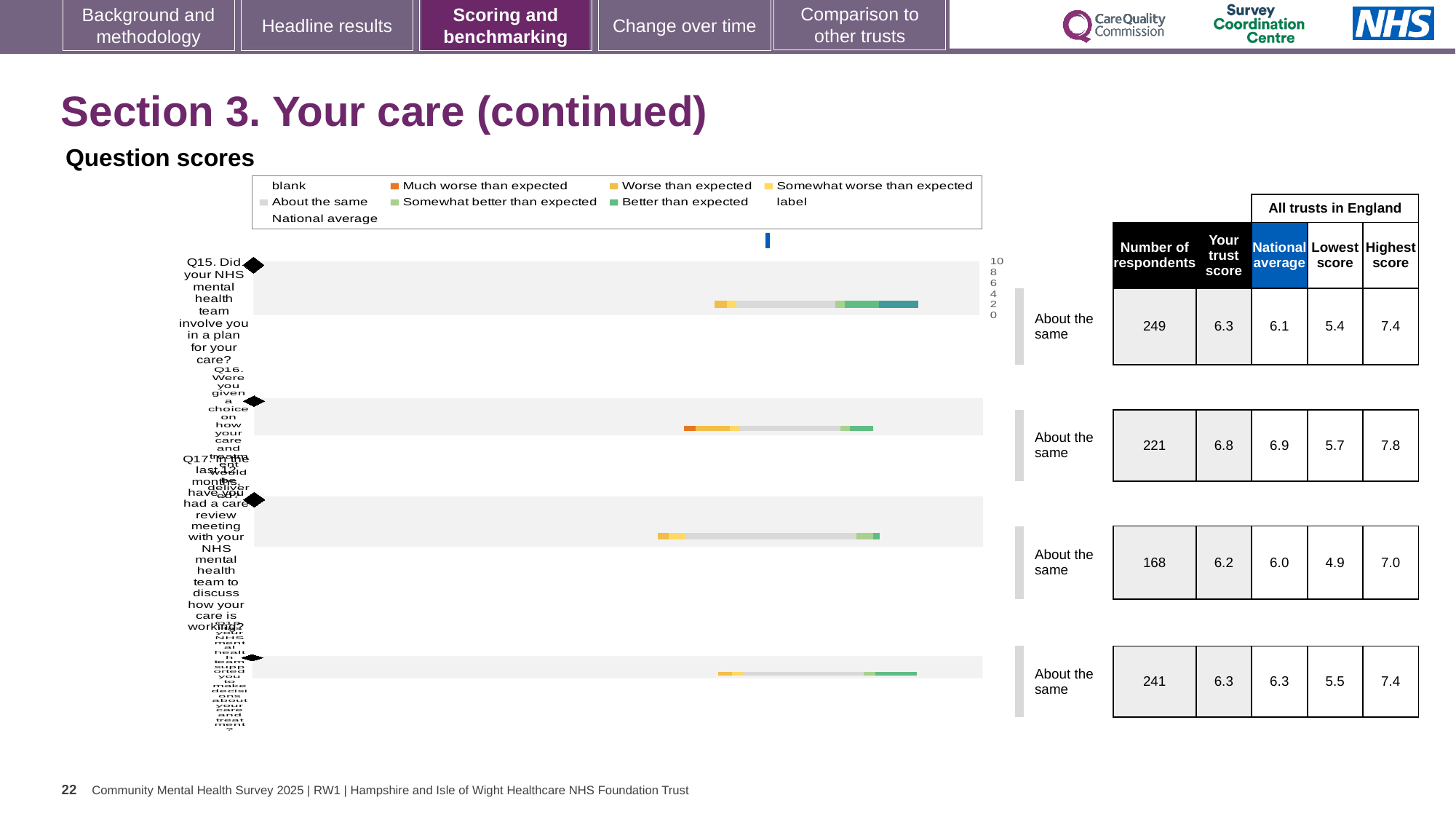
In the table beside the question scores chart, what is the difference between the highest score and the lowest score for Q15? 2.0 How many entries does the legend of the question scores chart list? 9 What is the highest value shown on the axis of the question scores chart? 10 In the table beside the question scores chart, what is the trust score for Q15? 6.3 What benchmark category is shown for Q16 in the question scores chart? About the same In the table beside the question scores chart, which has the larger trust score, Q16 or Q17? Q16 In the table beside the question scores chart, what is the number of respondents for Q17? 168 In the table beside the question scores chart, what is the national average for Q16? 6.9 What benchmark category is shown for Q15 in the question scores chart? About the same In the question scores chart legend, which colour represents 'Much worse than expected'? orange How many question bars are plotted in the question scores chart? 4 What kind of chart is used to show the question scores on this slide? bar chart